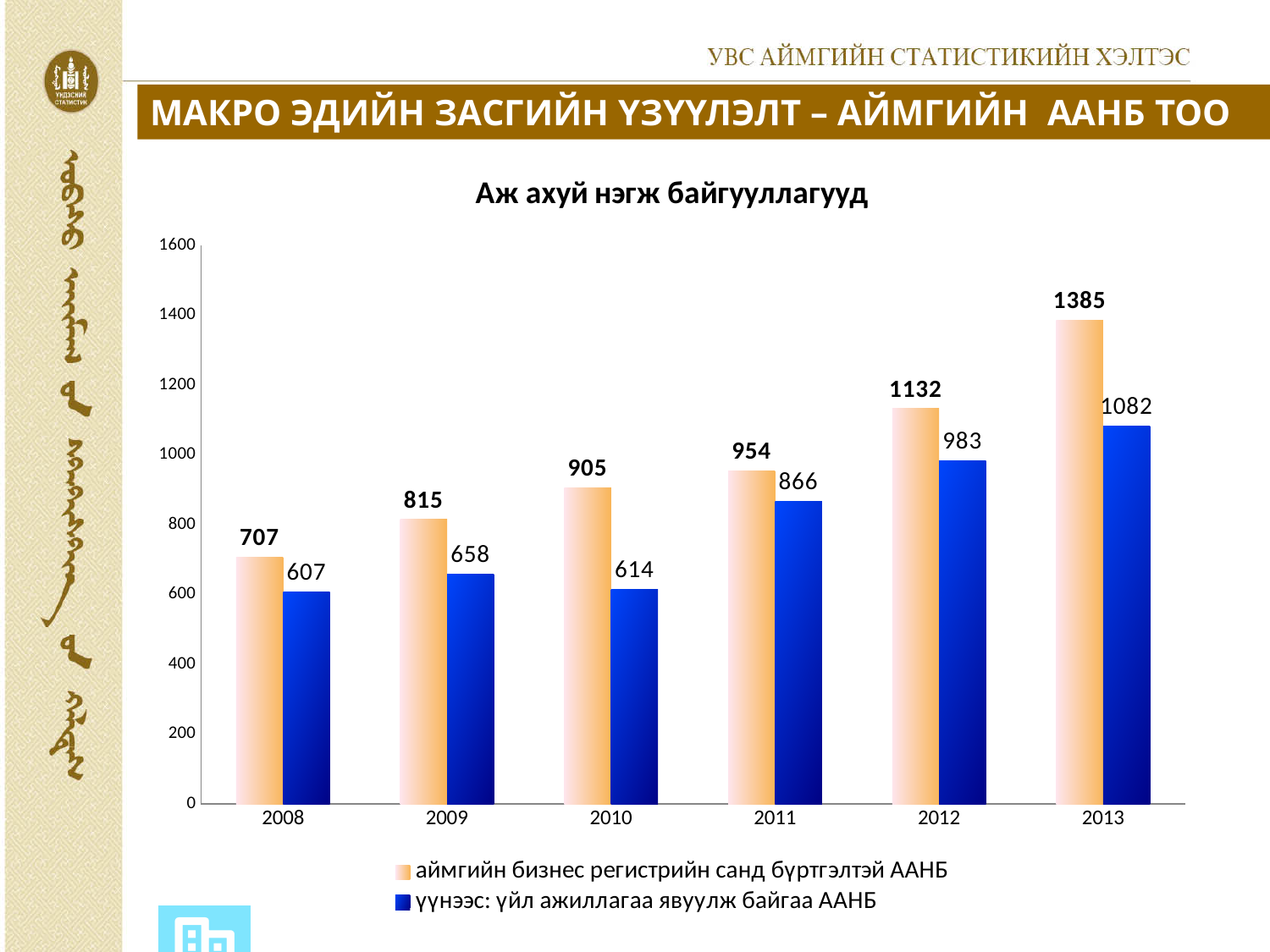
In which year is the value for 'үүнээс: үйл ажиллагаа явуулж байгаа ААНБ' lowest? 2008 What is the value for 'үүнээс: үйл ажиллагаа явуулж байгаа ААНБ' in 2012? 983 What is the difference between the 'аймгийн бизнес регистрийн санд бүртгэлтэй ААНБ' values for 2012 and 2011? 178 In which year is the value for 'аймгийн бизнес регистрийн санд бүртгэлтэй ААНБ' highest? 2013 How many years are shown on the x axis? 6 What kind of chart is shown? bar chart How many series does the legend list? 2 Which is larger: the 'үүнээс: үйл ажиллагаа явуулж байгаа ААНБ' value in 2009 or in 2010? 2009 What is the value for 'аймгийн бизнес регистрийн санд бүртгэлтэй ААНБ' in 2010? 905 What is the difference between the two series' values in 2013? 303 Does the value for 'аймгийн бизнес регистрийн санд бүртгэлтэй ААНБ' rise or fall from 2008 to 2013? rise Is the value for 'үүнээс: үйл ажиллагаа явуулж байгаа ААНБ' in 2011 greater or less than 800? greater